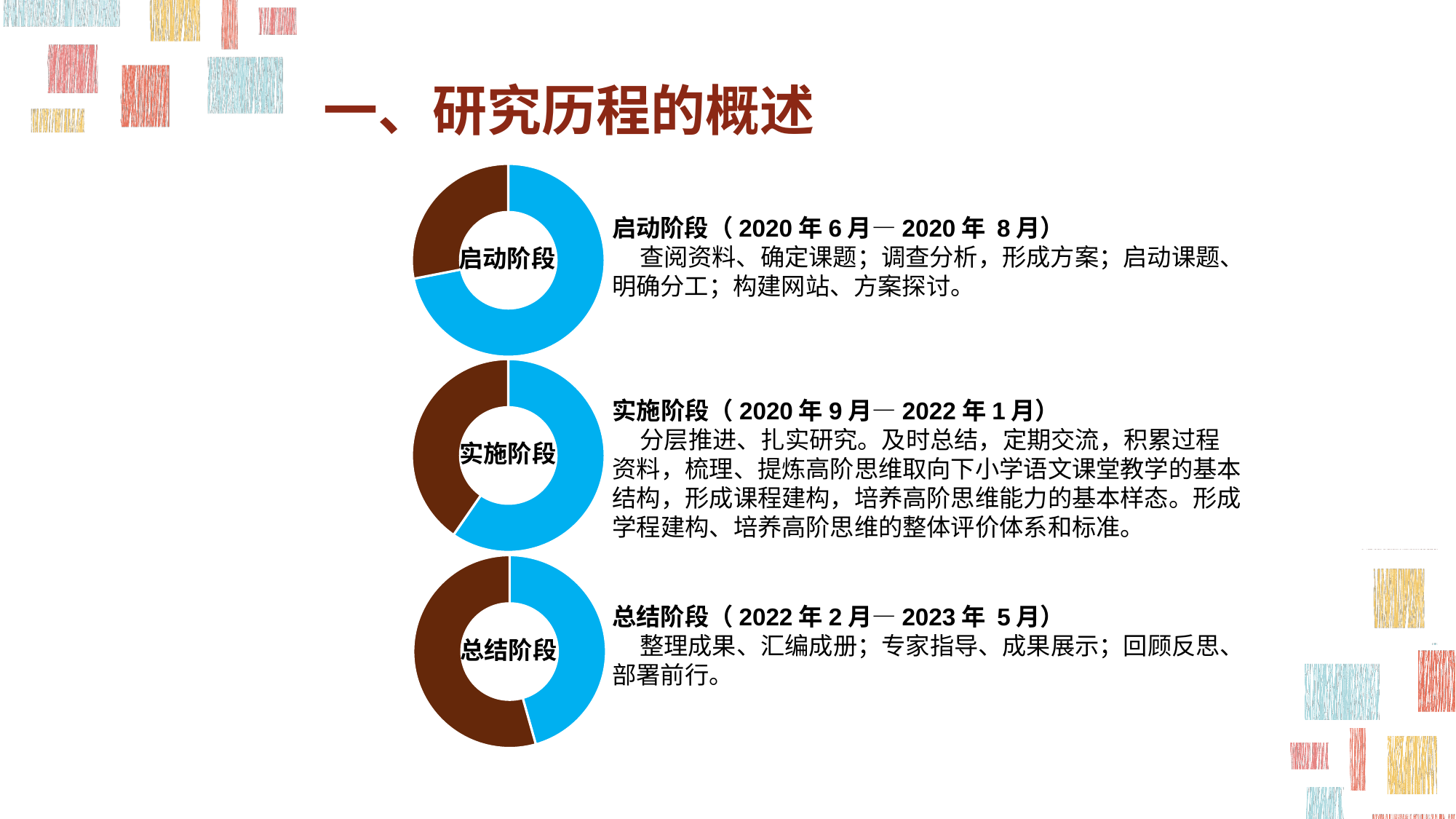
What kind of chart is used for each of the three stages on the slide? Doughnut (ring) chart How many slices does each doughnut chart contain? 2 Which of the three doughnut charts has the largest brown slice? 总结阶段 (bottom chart) Does the brown slice grow or shrink going from the top doughnut chart to the bottom one? Grows In the top doughnut chart (启动阶段), which slice is larger, the blue one or the brown one? Blue What label is printed in the centre of the top doughnut chart? 启动阶段 Which of the three doughnut charts has the smallest brown slice? 启动阶段 (top chart) What label is printed in the centre of the middle doughnut chart? 实施阶段 In the middle doughnut chart (实施阶段), which slice is larger, the blue one or the brown one? Blue How many doughnut charts are shown on the slide? 3